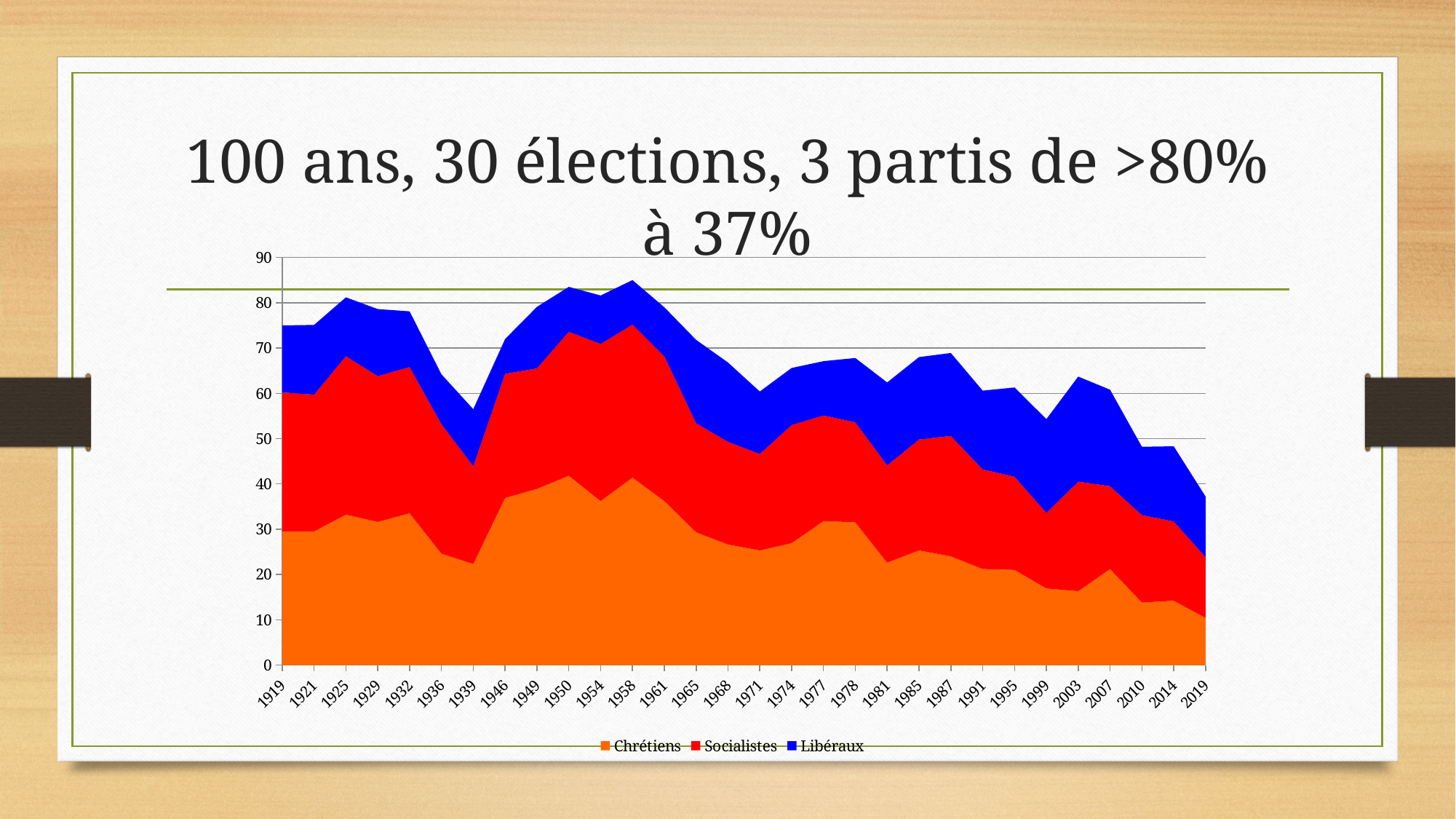
Is the combined total of the three parties in 1958 greater or less than 80? greater What is the first year shown on the x axis? 1919 Is the combined total of the three parties in 2019 greater or less than 40? less Is the combined total of the three parties in 1971 greater or less than 50? greater Which series is shown in blue in the legend? Libéraux How many series does the legend list? 3 Overall, does the combined total of the three parties rise or fall from 1919 to 2019? fall What kind of chart is shown on the slide? Stacked area chart In which year is the combined total of the three parties lowest? 2019 How many election years are plotted along the x axis? 30